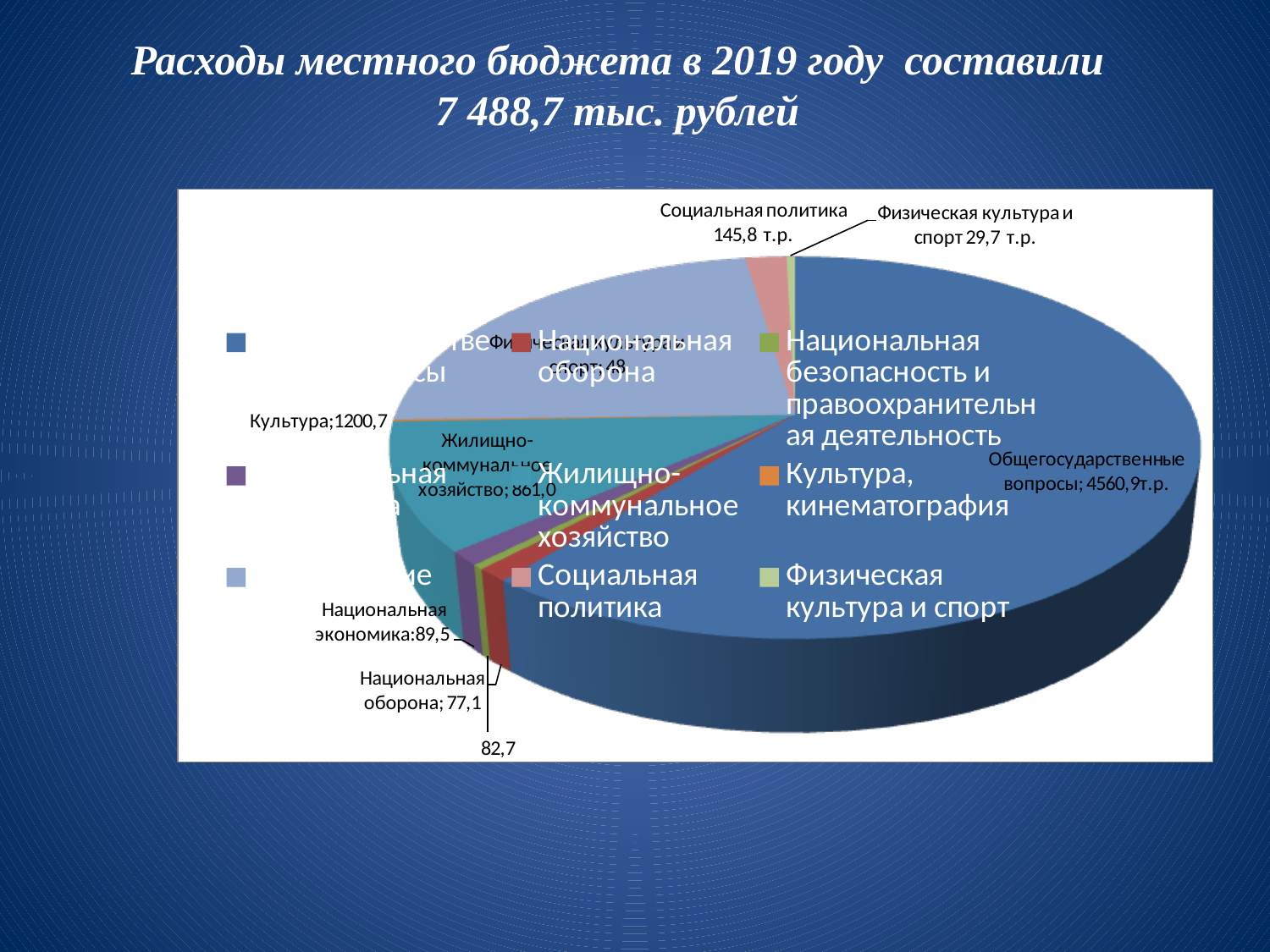
What is the value shown for Национальная экономика? 89,5 What kind of chart is shown on the slide? pie chart Which category has the largest slice of the pie? Общегосударственные вопросы Which is larger, Культура or Жилищно-коммунальное хозяйство? Культура What is the value shown for Физическая культура и спорт? 29,7 т.р. What is the value shown for Национальная оборона? 77,1 According to the slide title, what was the total of local budget expenditures in 2019? 7 488,7 тыс. рублей What is the difference between the values for Социальная политика and Физическая культура и спорт? 116,1 What is the value shown for Культура? 1200,7 What is the value shown for Общегосударственные вопросы? 4560,9 т.р. What is the value shown for Жилищно-коммунальное хозяйство? 861,0 What is the value shown for Социальная политика? 145,8 т.р.